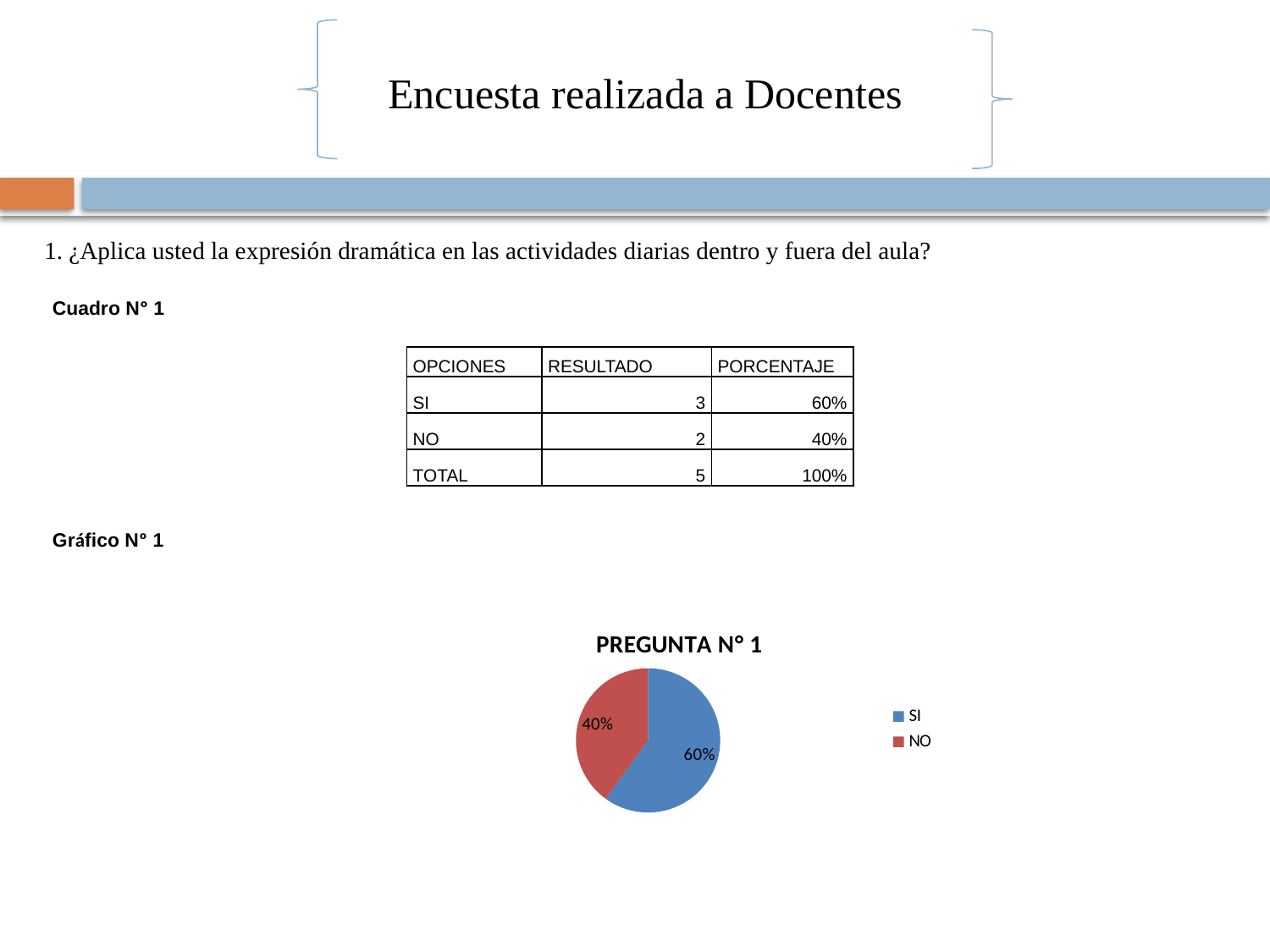
What kind of chart is shown on the slide? pie chart Which slice of the pie chart is the largest? SI What is the difference in percentage points between the SI and NO slices? 20% What colour is the SI slice in the pie chart? blue What percentage does the NO slice show in the pie chart? 40% What percentage does the SI slice show in the pie chart? 60% Which is larger in the pie chart, SI or NO? SI How many entries does the chart legend list? 2 What is the title of the chart? PREGUNTA N° 1 What share of the pie does the NO slice represent? 40% How many slices does the pie chart have? 2 Which slice of the pie chart is the smallest? NO